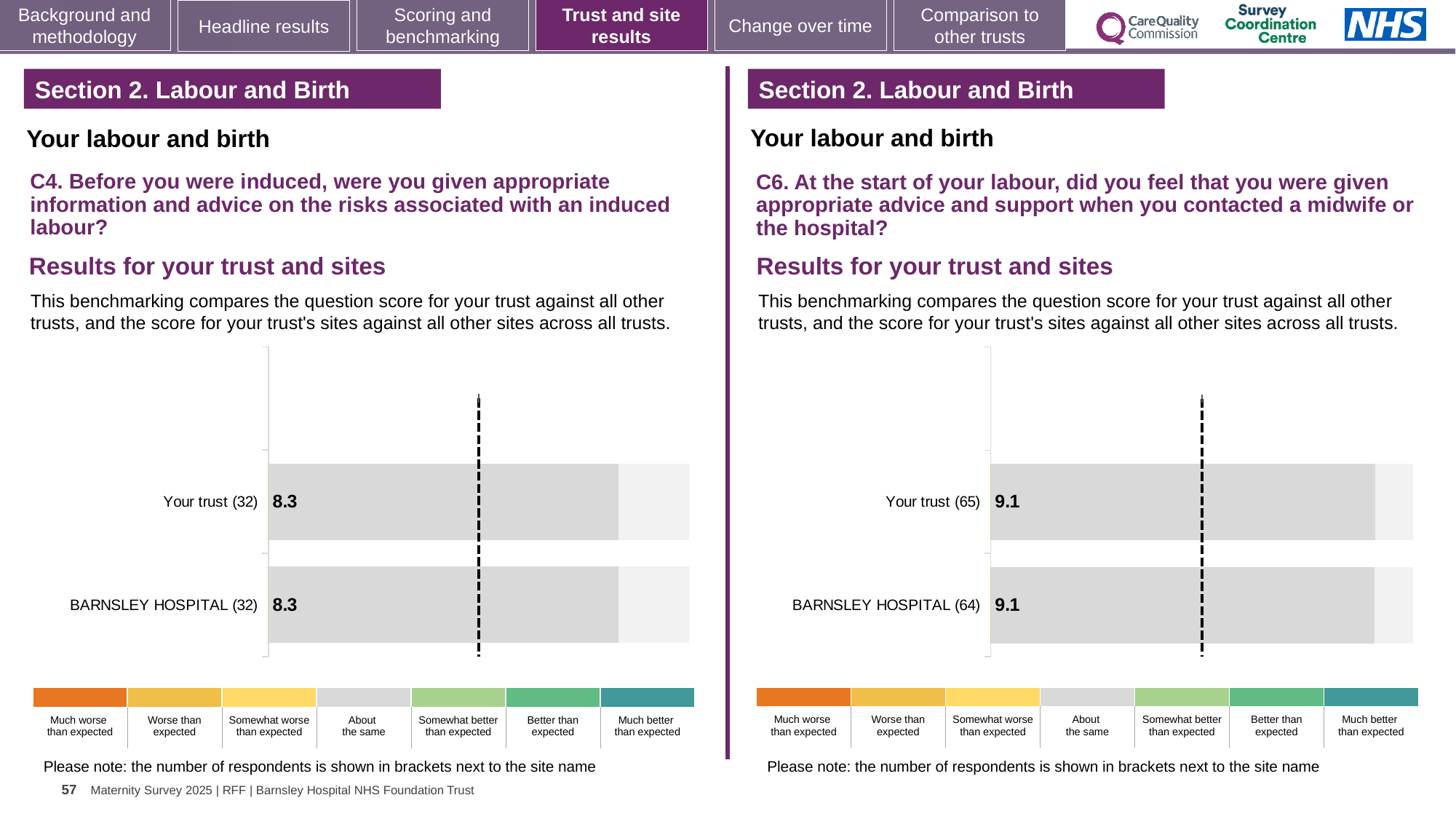
On the C6 chart (right), what is the score for BARNSLEY HOSPITAL? 9.1 On the C4 chart (left), what is the score for BARNSLEY HOSPITAL? 8.3 On the C6 chart (right), how many respondents are shown in brackets for BARNSLEY HOSPITAL? 64 On the C4 chart (left), what is the difference between the score for Your trust and the score for BARNSLEY HOSPITAL? 0 What kind of chart is the C4 chart (left)? Bar chart On the C4 chart (left), what is the score for Your trust? 8.3 On the C6 chart (right), how many bars are plotted? 2 On the C6 chart (right), what is the score for Your trust? 9.1 What is the difference between the Your trust score on the C6 chart (right) and the Your trust score on the C4 chart (left)? 0.8 On the C6 chart (right), is the score for Your trust larger than, smaller than, or the same as the score for BARNSLEY HOSPITAL? The same On the C4 chart (left), how many bars are plotted? 2 On the C6 chart (right), how many respondents are shown in brackets for Your trust? 65